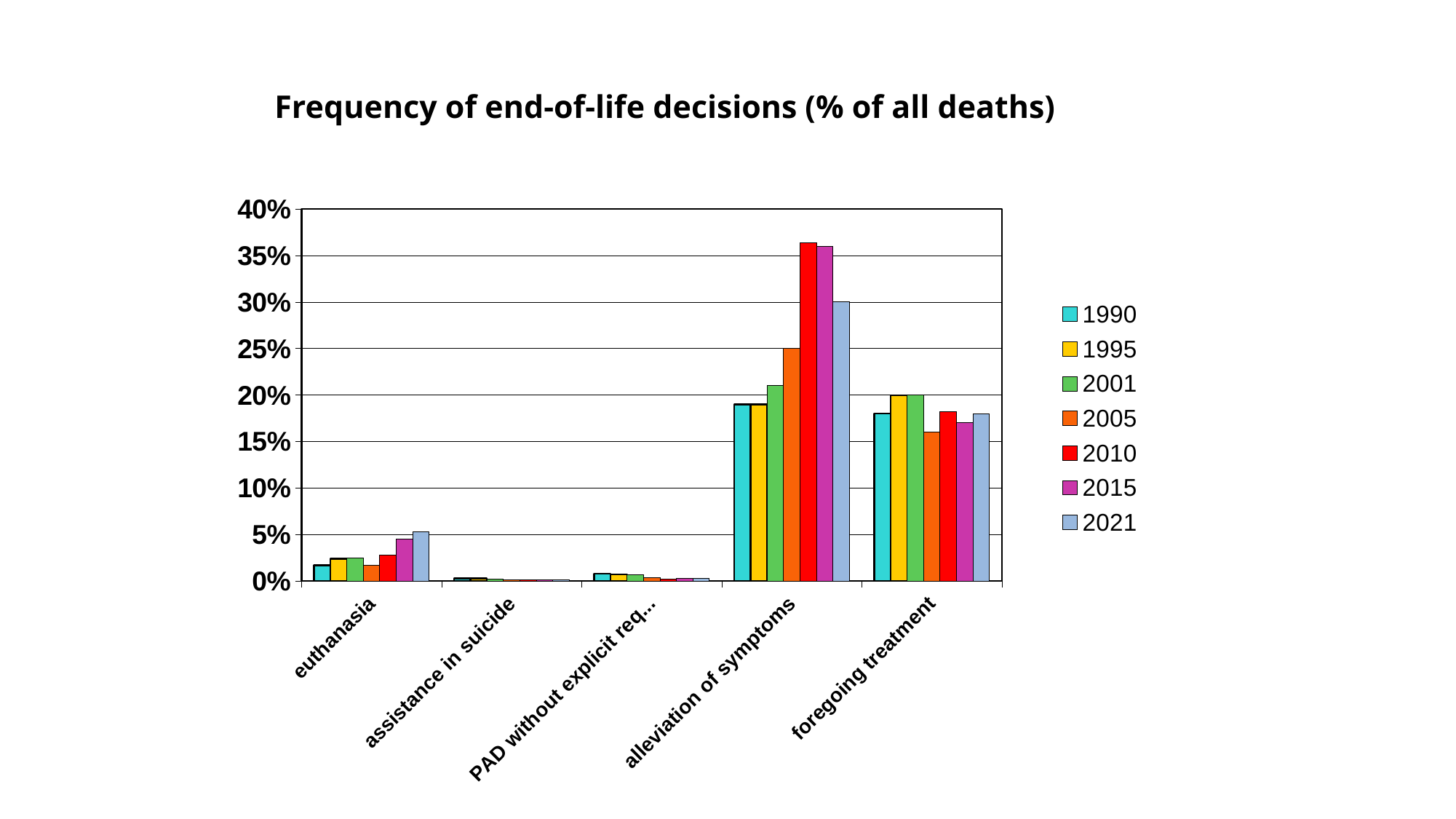
How many series does the legend list? 7 For 2021, which is larger: alleviation of symptoms or foregoing treatment? alleviation of symptoms Which category has the highest value for 2010? alleviation of symptoms Do the values for alleviation of symptoms rise or fall from 1990 to 2010? rise What is the title of the chart? Frequency of end-of-life decisions (% of all deaths) Within the euthanasia category, which year has the highest value? 2021 Is the value for foregoing treatment in 2005 greater or less than 20%? less How many categories are shown on the x axis? 5 Is the value for alleviation of symptoms in 2010 greater or less than 30%? greater Which category has the lowest values overall? assistance in suicide What kind of chart is shown on the slide? bar chart Is the value for euthanasia in 2021 greater or less than 10%? less